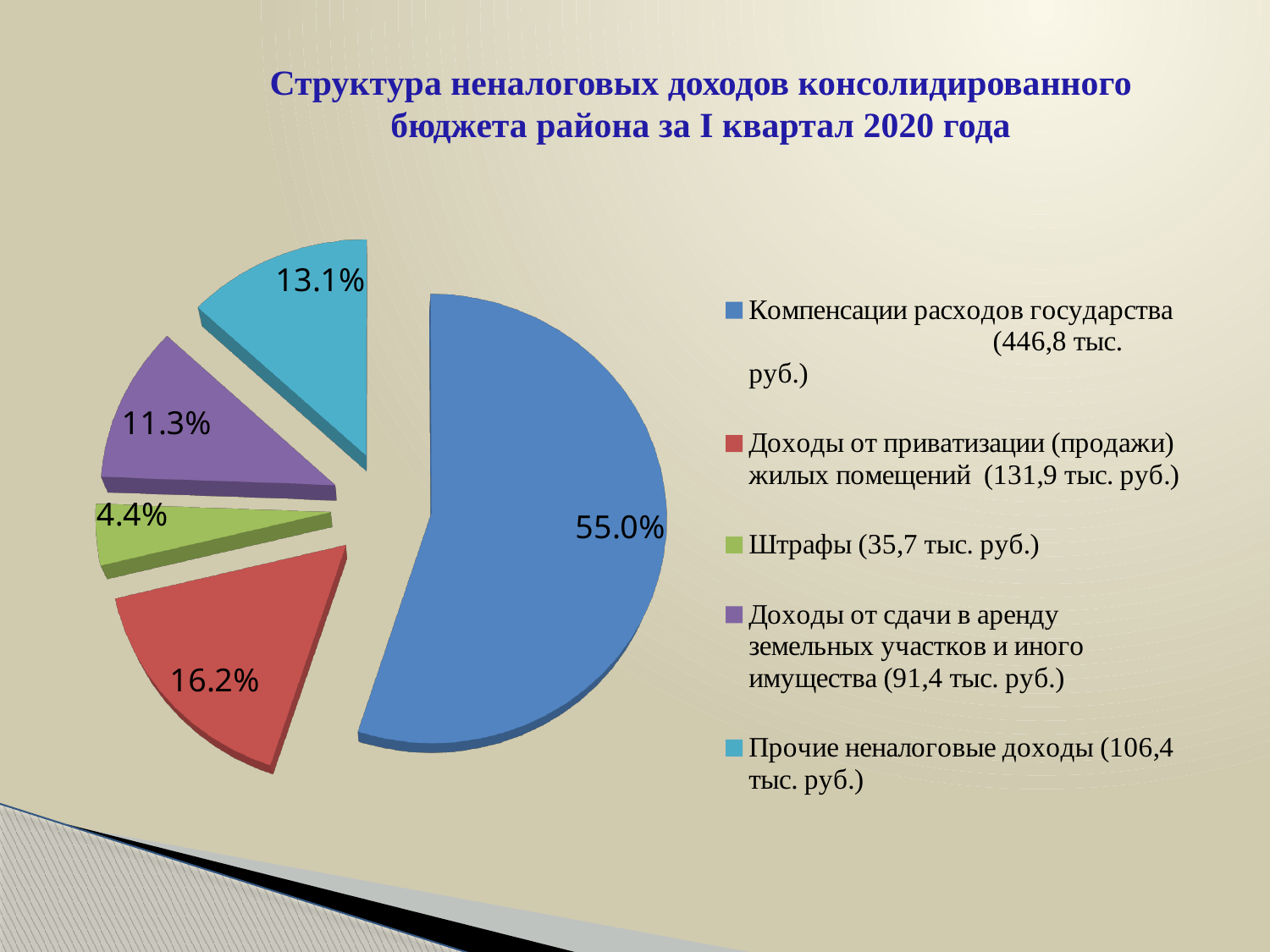
Which slice is larger: "Прочие неналоговые доходы" or "Доходы от сдачи в аренду земельных участков и иного имущества"? Прочие неналоговые доходы What share of the pie does "Компенсации расходов государства" take? 55.0% What colour is the slice for "Доходы от приватизации (продажи) жилых помещений"? red What kind of chart is shown on the slide? pie chart What is the difference in percentage points between the "Доходы от приватизации (продажи) жилых помещений" slice and the "Штрафы" slice? 11.8 Which category has the largest slice of the pie? Компенсации расходов государства What share of the pie does "Доходы от сдачи в аренду земельных участков и иного имущества" take? 11.3% What amount in thousand rubles does the legend give for "Штрафы"? 35,7 тыс. руб. How many slices does the pie chart have? 5 What share of the pie does "Штрафы" take? 4.4% Which category has the smallest slice of the pie? Штрафы